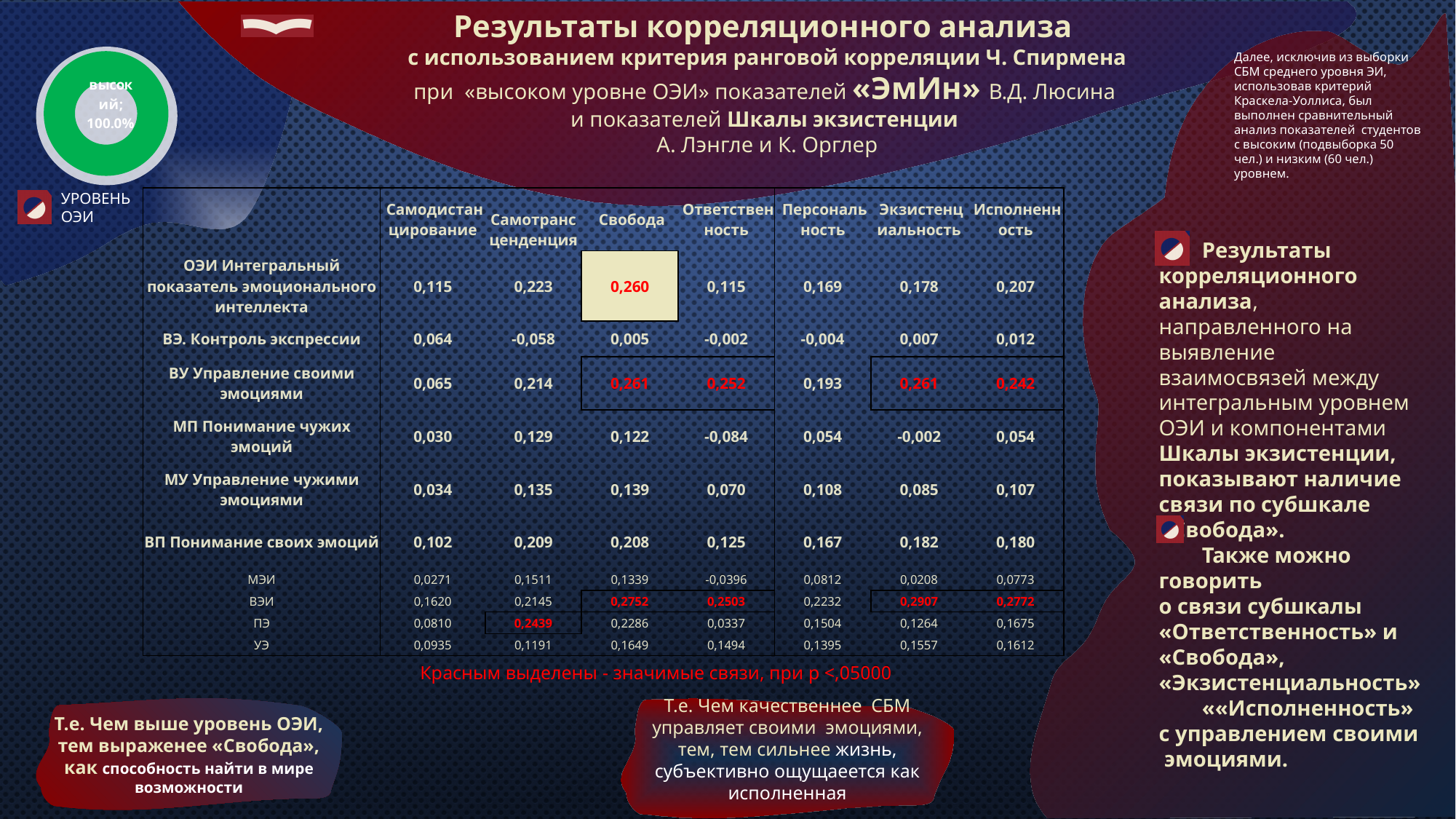
What colour is the slice in the doughnut chart in the top-left corner? green What is the label of the only slice in the doughnut chart in the top-left corner? высокий What kind of chart is shown in the top-left corner of the slide? pie chart (doughnut) In the doughnut chart in the top-left corner, what share does the slice labelled "высокий" have? 100.0% What caption is written next to the doughnut chart in the top-left corner? УРОВЕНЬ ОЭИ How many slices does the doughnut chart in the top-left corner show? 1